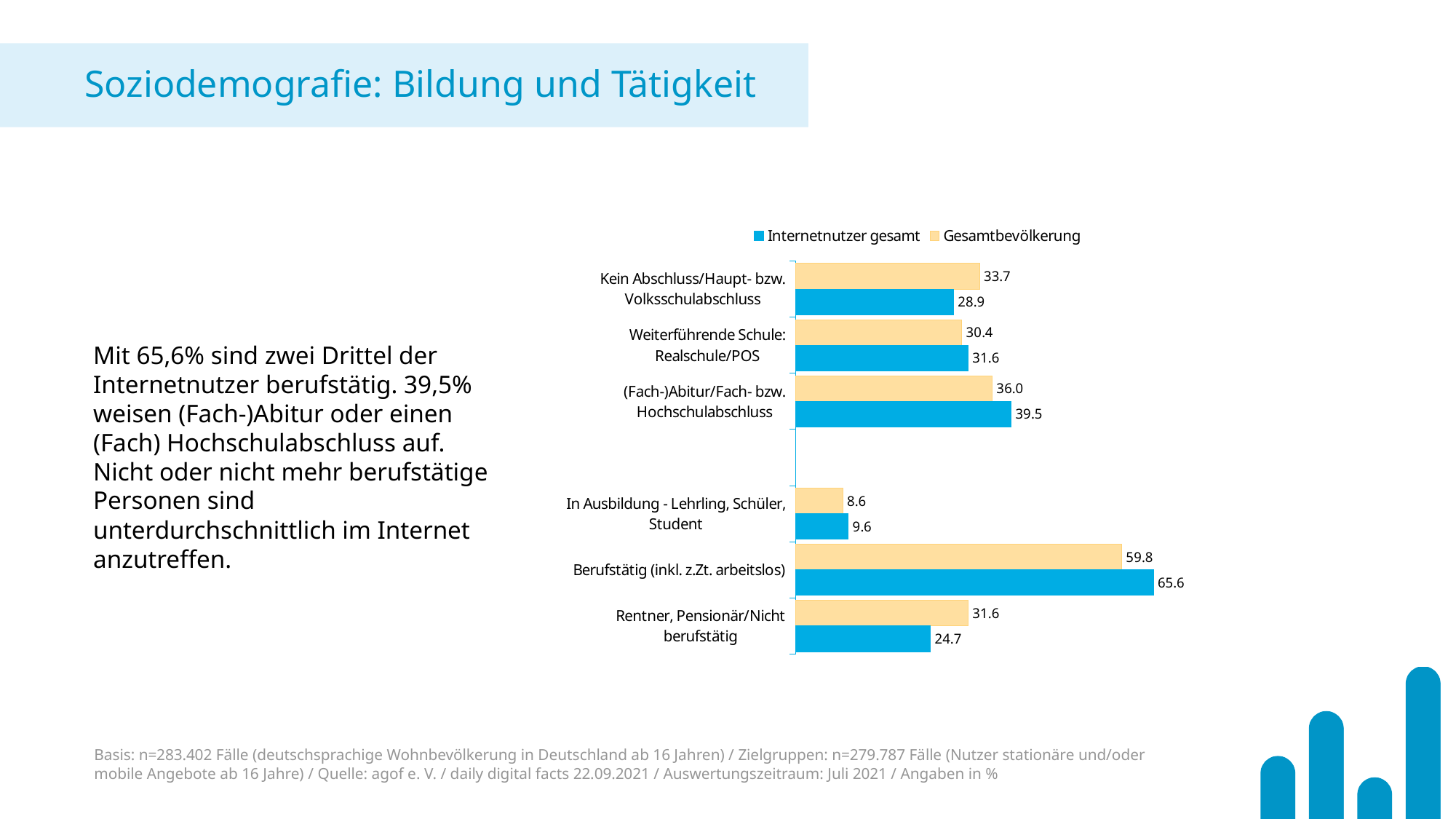
How many series does the legend list? 2 What kind of chart is shown on the slide? Bar chart What is the value for Internetnutzer gesamt in the category Berufstätig (inkl. z.Zt. arbeitslos)? 65.6 In the category Rentner, Pensionär/Nicht berufstätig, which series has the larger value: Internetnutzer gesamt or Gesamtbevölkerung? Gesamtbevölkerung What is the value for Internetnutzer gesamt in the category In Ausbildung - Lehrling, Schüler, Student? 9.6 What is the value for Gesamtbevölkerung in the category Rentner, Pensionär/Nicht berufstätig? 31.6 Which category has the highest value for Internetnutzer gesamt? Berufstätig (inkl. z.Zt. arbeitslos) In the category (Fach-)Abitur/Fach- bzw. Hochschulabschluss, which series has the larger value: Internetnutzer gesamt or Gesamtbevölkerung? Internetnutzer gesamt What is the value for Gesamtbevölkerung in the category Kein Abschluss/Haupt- bzw. Volksschulabschluss? 33.7 What is the difference between Internetnutzer gesamt and Gesamtbevölkerung in the category Berufstätig (inkl. z.Zt. arbeitslos)? 5.8 Which category has the lowest value for Gesamtbevölkerung? In Ausbildung - Lehrling, Schüler, Student How many categories are shown in the chart? 6